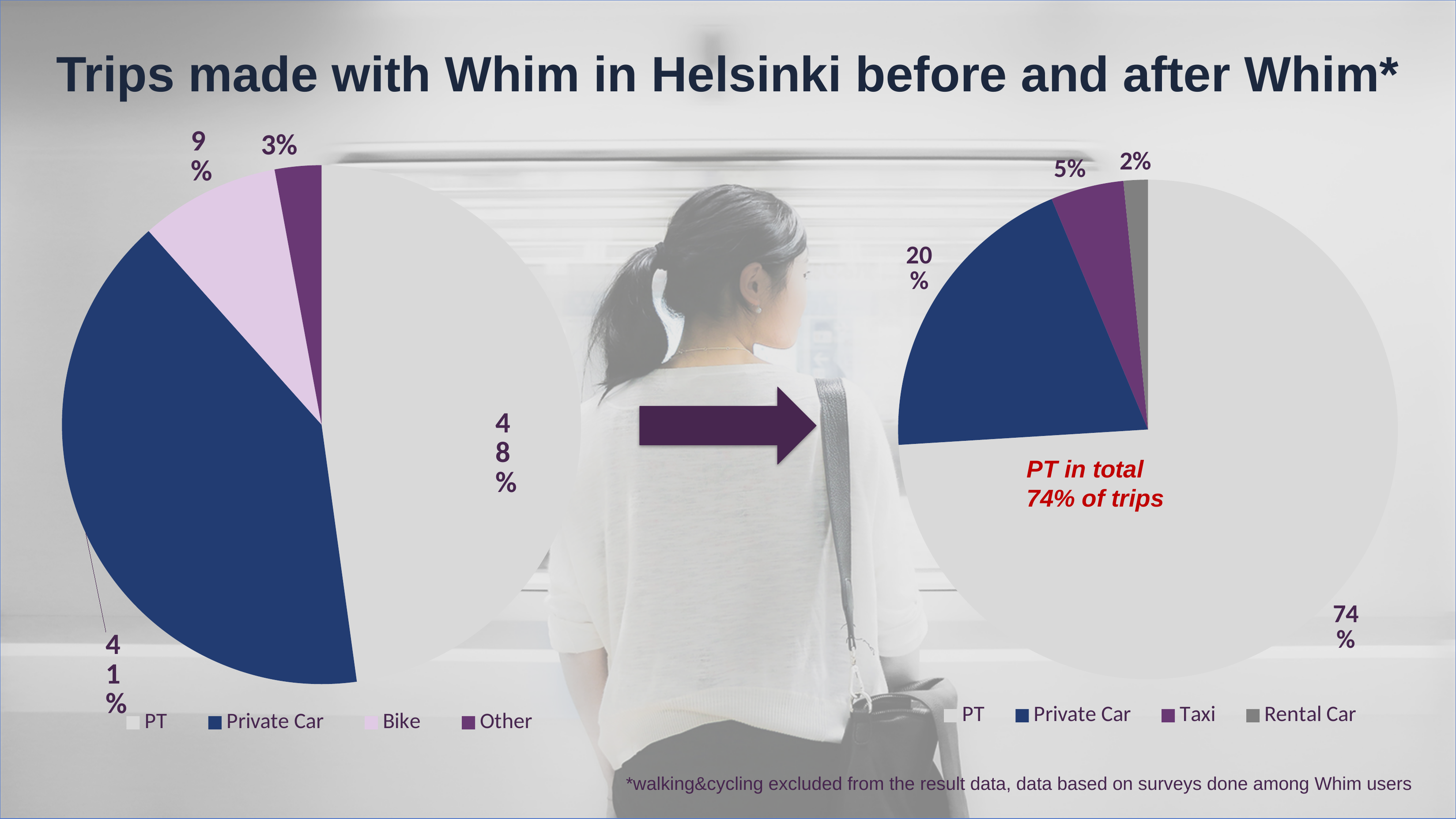
In the left pie chart, what share of trips is Private Car? 41% In the left pie chart, what share of trips is Bike? 9% What kind of charts are shown on the slide? Pie charts In the right pie chart, which is larger: Private Car or Taxi? Private Car What is the difference between the PT share in the right pie chart and the PT share in the left pie chart? 26% In the right pie chart, which category has the smallest share? Rental Car In the right pie chart, what share of trips is PT? 74% In the left pie chart, what share of trips is PT? 48% In the left pie chart, which category has the largest share? PT What is the title of the slide? Trips made with Whim in Helsinki before and after Whim* How many categories does the legend of the right pie chart list? 4 In the right pie chart, what share of trips is Taxi? 5%